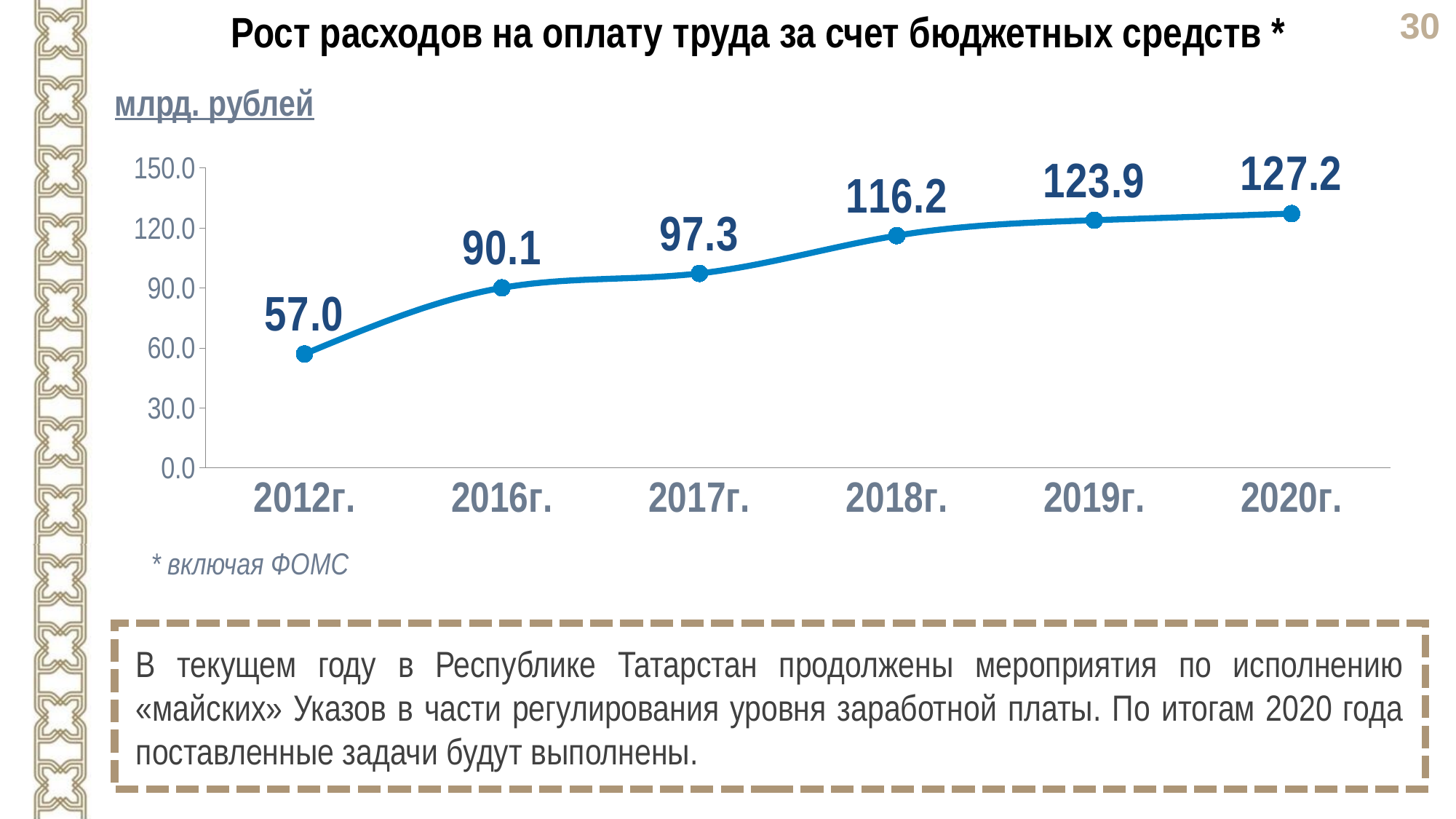
What is the value for 2018г.? 116.2 What kind of chart is shown on the slide? line chart What is the difference between the values for 2020г. and 2012г.? 70.2 What is the value for 2020г.? 127.2 Is the value for 2016г. greater or less than 120.0? less Which year has the highest value? 2020г. Which is larger, the value for 2019г. or the value for 2017г.? 2019г. Which year has the lowest value? 2012г. Do the values rise or fall from 2012г. to 2020г.? rise How many data points are plotted on the chart? 6 What is the difference between the values for 2017г. and 2016г.? 7.2 What is the value for 2012г.? 57.0